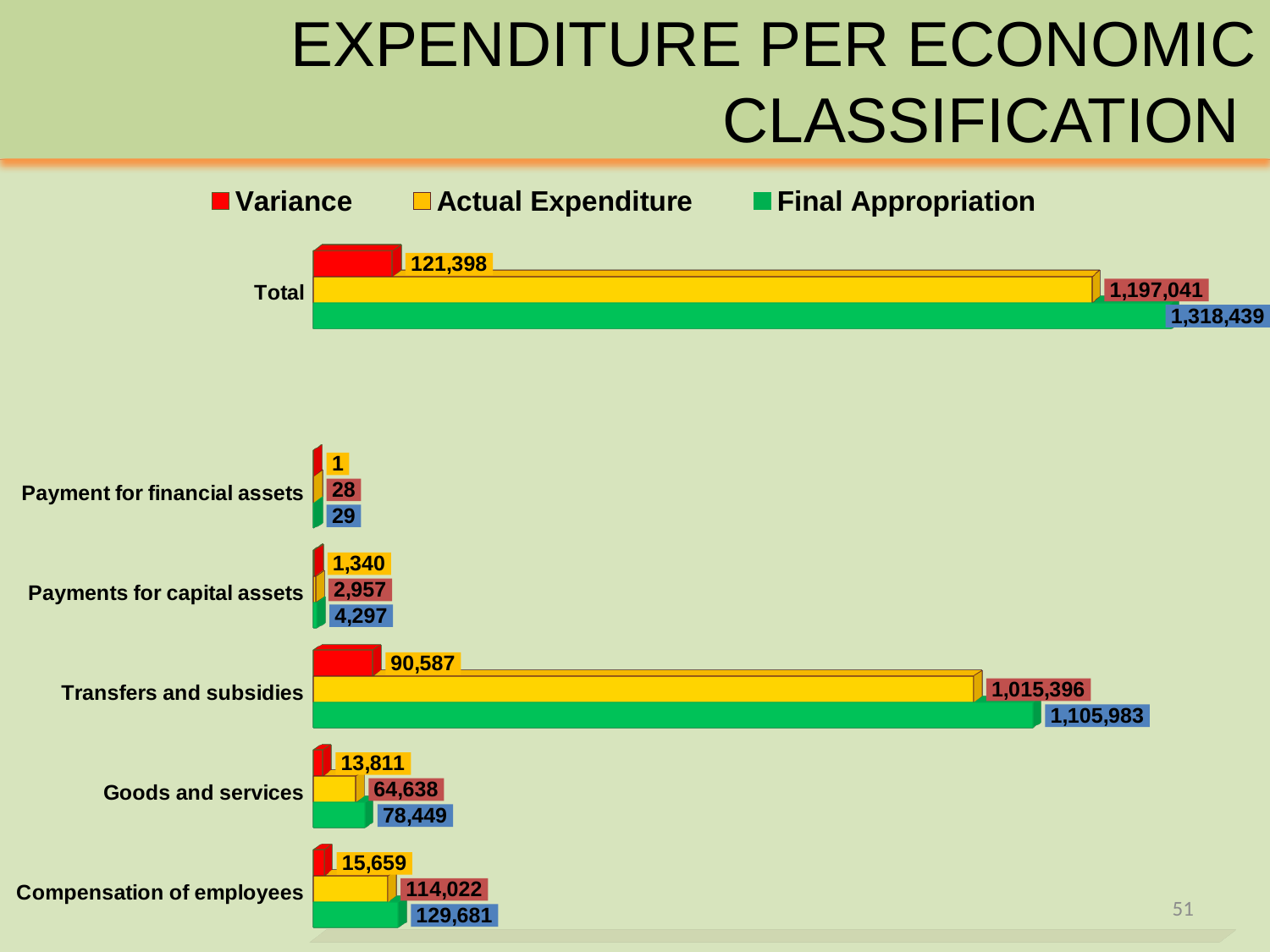
What is the Final Appropriation value for Transfers and subsidies? 1,105,983 What is the Final Appropriation value for Payment for financial assets? 29 What is the difference between the Final Appropriation and Actual Expenditure for Goods and services? 13,811 What kind of chart is shown on the slide? Bar chart What is the Actual Expenditure value for Compensation of employees? 114,022 How many categories are shown on the chart? 6 Which colour represents Final Appropriation in the chart? Green Which is larger, the Variance for Compensation of employees or the Variance for Goods and services? Compensation of employees Which category has the lowest Variance? Payment for financial assets Excluding Total, which category has the highest Actual Expenditure? Transfers and subsidies What is the Variance value for Goods and services? 13,811 How many series does the legend list? 3